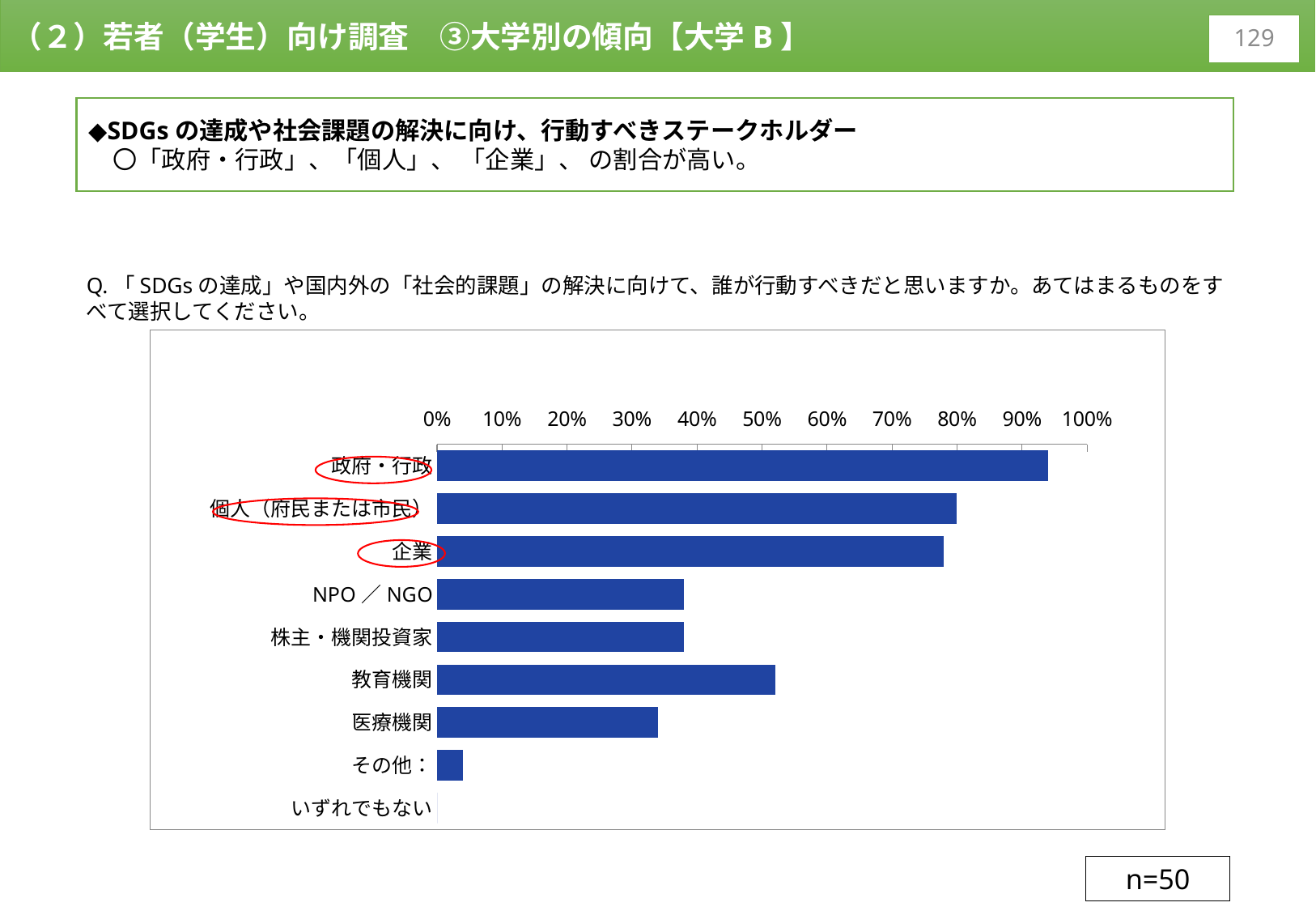
Is the value for 企業 greater or less than 70%? greater Which category has the lowest value in the chart? いずれでもない Is the value for 個人（府民または市民） greater or less than 70%? greater How many categories are listed on the chart's vertical axis? 9 Which is larger, the value for 教育機関 or the value for NPO／NGO? 教育機関 Is the value for その他： greater or less than 10%? less What kind of chart is shown on the slide? bar chart What sample size (n) is shown on the slide for this chart? n=50 Which category has the highest value in the chart? 政府・行政